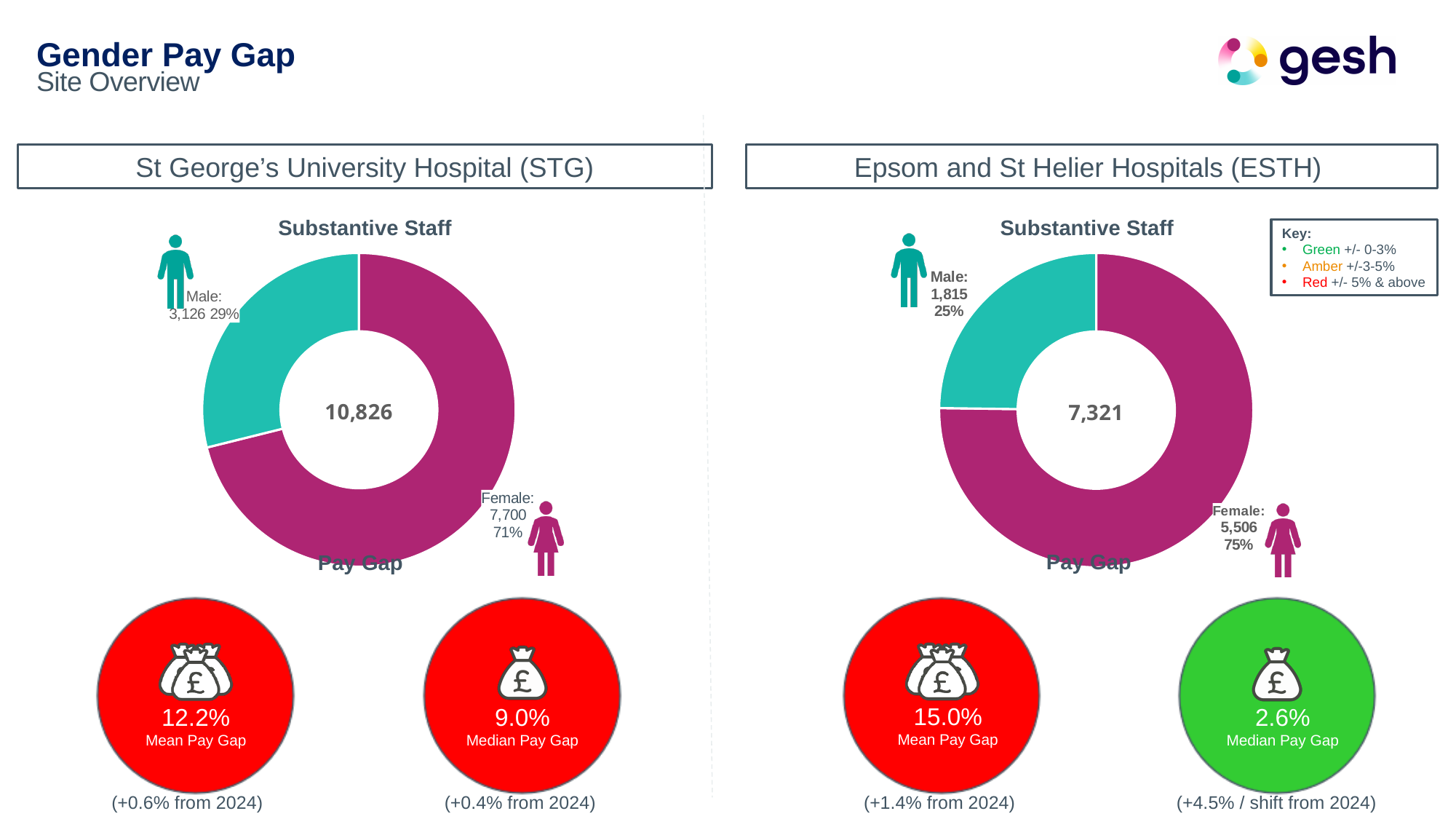
What total number is shown in the centre of the St George's University Hospital (STG) Substantive Staff chart? 10,826 In the Epsom and St Helier Hospitals (ESTH) Substantive Staff chart, what is the difference between the number of female and male staff? 3,691 In the St George's University Hospital (STG) Substantive Staff chart, which group is larger, male or female? Female In the St George's University Hospital (STG) Substantive Staff chart, what is the difference between the number of female and male staff? 4,574 In the St George's University Hospital (STG) Substantive Staff chart, what percentage of staff are female? 71% In the Epsom and St Helier Hospitals (ESTH) Substantive Staff chart, what percentage of staff are male? 25% What kind of chart is used to show Substantive Staff for each hospital? Donut (pie) chart What total number is shown in the centre of the Epsom and St Helier Hospitals (ESTH) Substantive Staff chart? 7,321 In the Epsom and St Helier Hospitals (ESTH) Substantive Staff chart, which group is the smallest? Male In the Epsom and St Helier Hospitals (ESTH) Substantive Staff chart, how many female staff are shown? 5,506 How many categories does the St George's University Hospital (STG) Substantive Staff chart show? 2 In the St George's University Hospital (STG) Substantive Staff chart, how many male staff are shown? 3,126